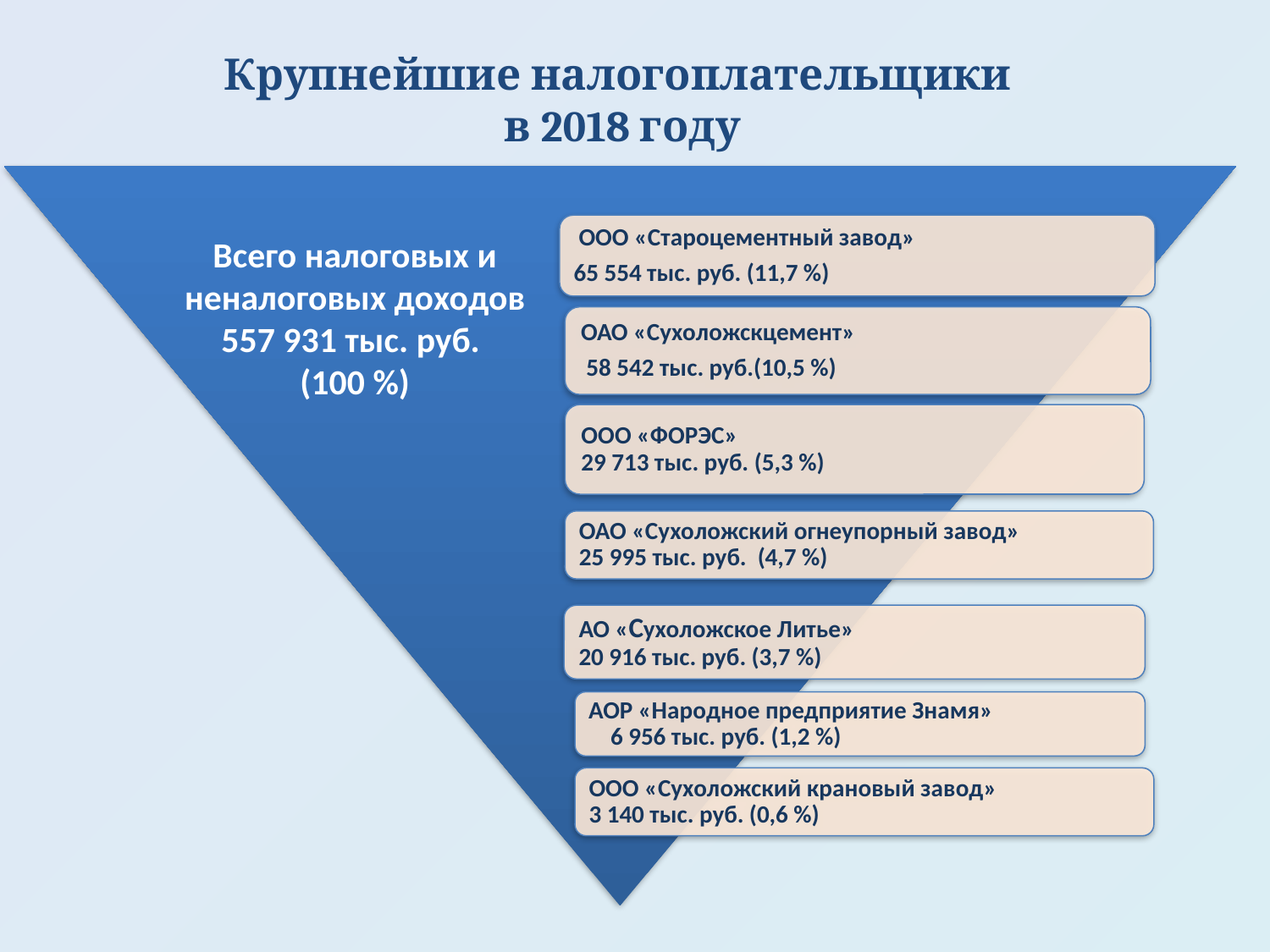
What amount is shown for АОР «Народное предприятие Знамя»? 6 956 тыс. руб. What amount is shown for ООО «Староцементный завод»? 65 554 тыс. руб. Which taxpayer has the lowest amount? ООО «Сухоложский крановый завод» How many taxpayers are listed in the diagram? 7 What is the difference in тыс. руб. between ООО «Староцементный завод» and ОАО «Сухоложскцемент»? 7 012 тыс. руб. Which taxpayer has the highest amount? ООО «Староцементный завод» What share is shown for АО «Сухоложское Литье»? 3,7 % Which is larger: the amount for ООО «ФОРЭС» or for ОАО «Сухоложский огнеупорный завод»? ООО «ФОРЭС» What is the total of tax and non-tax revenues shown on the slide? 557 931 тыс. руб. What amount is shown for ООО «ФОРЭС»? 29 713 тыс. руб. What share of total revenue is attributed to ОАО «Сухоложскцемент»? 10,5 % Do the amounts increase or decrease from the top entry to the bottom entry? decrease